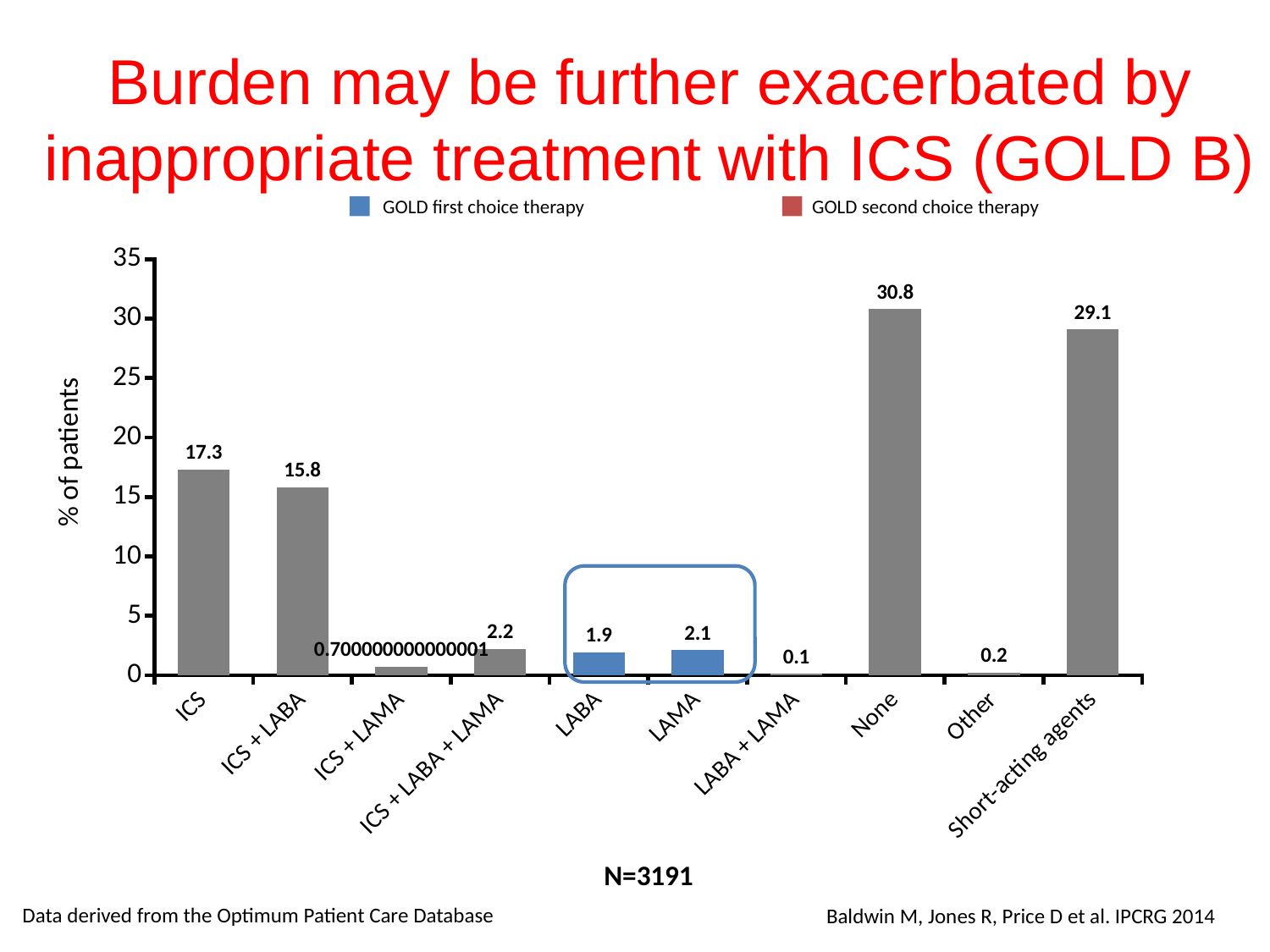
How many categories are shown on the x axis? 10 Which is larger, the value for LABA or the value for LAMA? LAMA Which category has the lowest value? LABA + LAMA What is the value for Short-acting agents? 29.1 What is the value for ICS + LABA? 15.8 What type of chart is shown on the slide? Bar chart Which category has the highest value? None How many series does the legend list? 2 What is the difference between the values for ICS and ICS + LABA? 1.5 What is the value for None? 30.8 What is the difference between the values for None and Short-acting agents? 1.7 What is the value for LAMA? 2.1